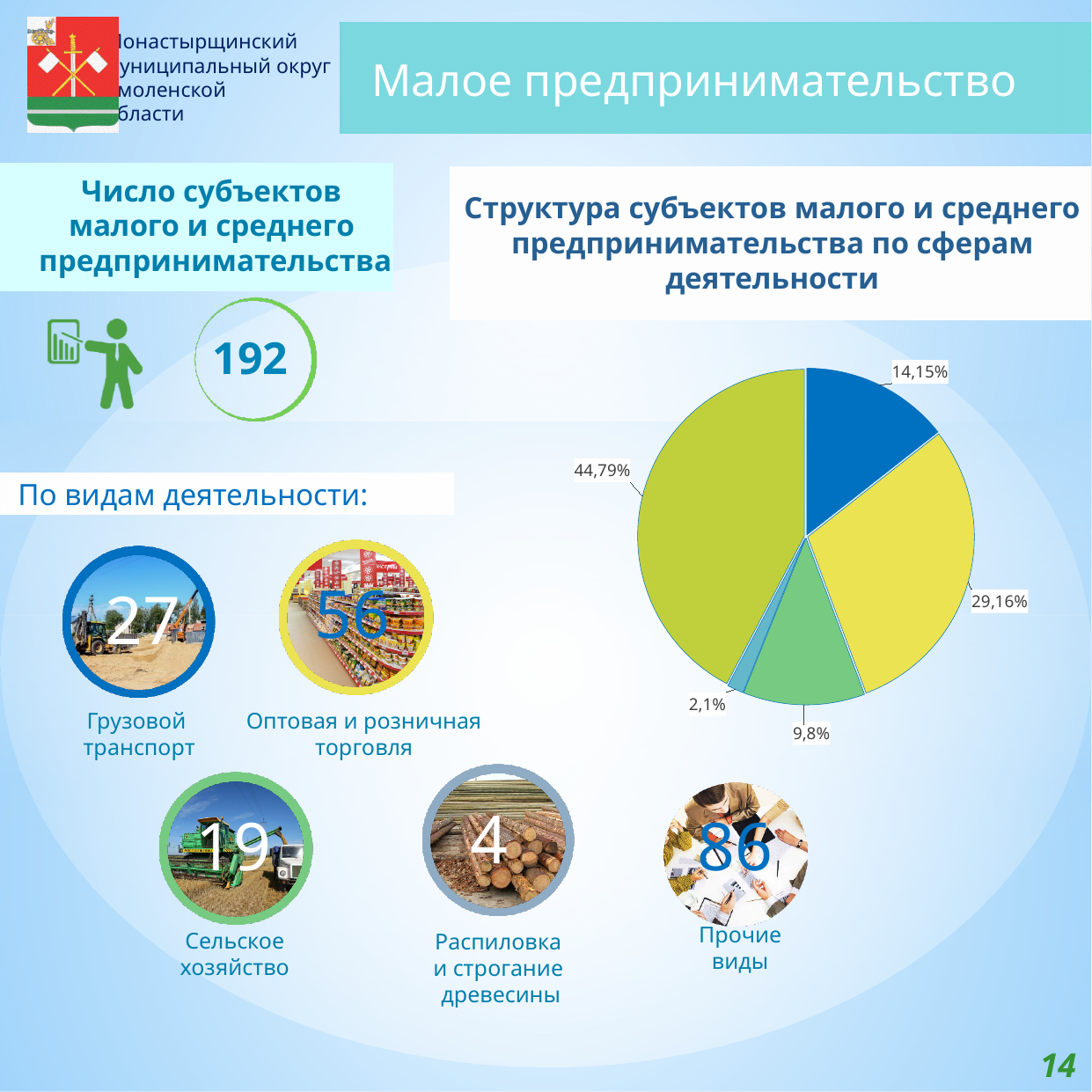
What kind of chart is shown on the slide? pie chart What is the title of the pie chart? Структура субъектов малого и среднего предпринимательства по сферам деятельности What colour is the largest slice of the pie chart? yellow-green What is the value of the smallest slice of the pie chart? 2,1% What is the value of the yellow slice of the pie chart? 29,16% What is the value of the green slice of the pie chart? 9,8% How many slices does the pie chart have? 5 What is the value of the dark blue slice of the pie chart? 14,15% Which slice is larger: the dark blue slice or the yellow slice? the yellow slice What is the value of the largest slice of the pie chart? 44,79% What is the difference between the largest slice (44,79%) and the yellow slice (29,16%)? 15,63% What is the difference between the dark blue slice (14,15%) and the green slice (9,8%)? 4,35%